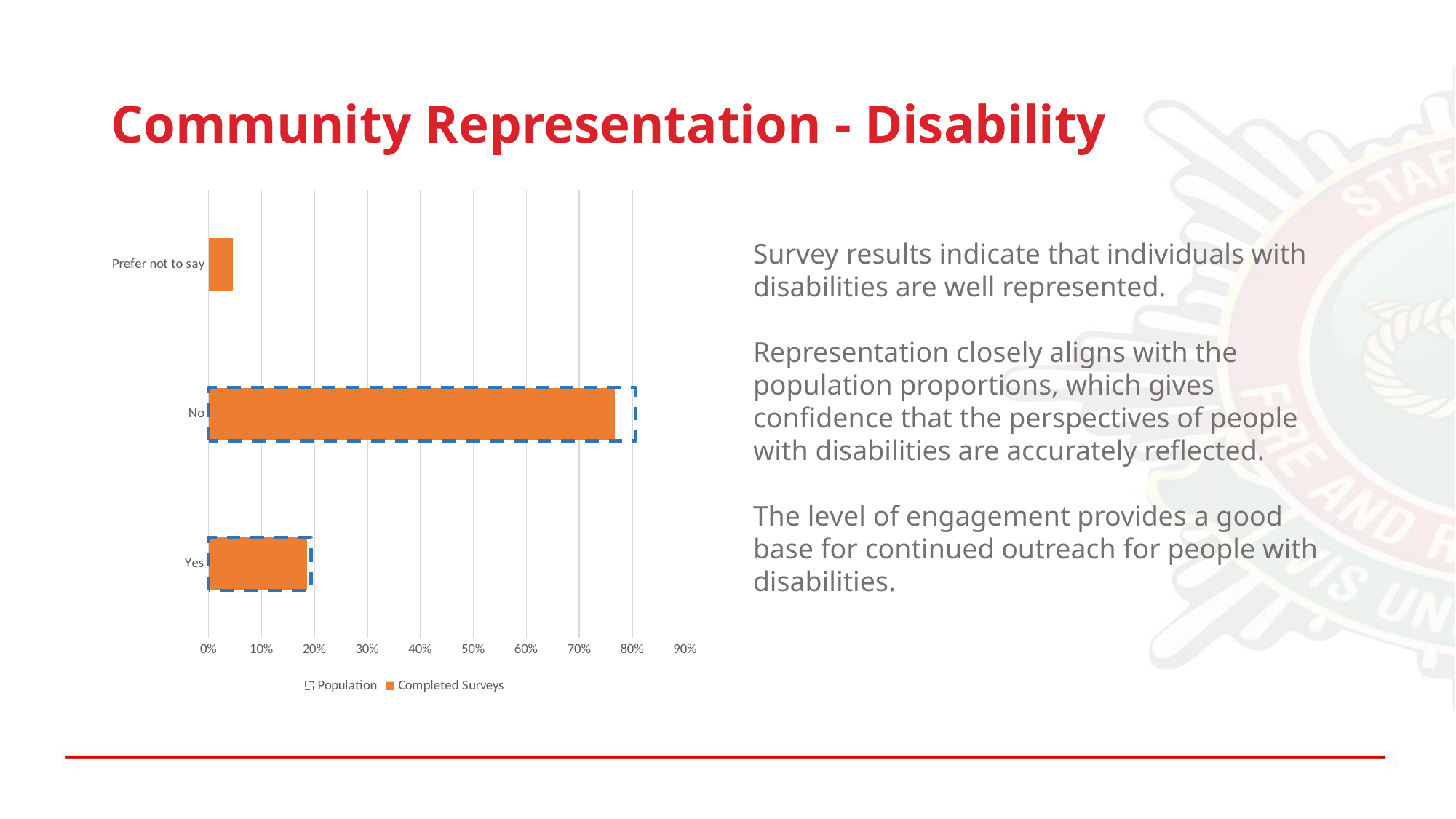
Which series is shown with a dashed outline in the legend? Population Which category has the lowest Completed Surveys value? Prefer not to say What kind of chart is shown on the slide? Bar chart Which category has the highest Completed Surveys value? No Is the Completed Surveys value for No greater or less than 70%? greater How many series does the chart's legend list? 2 What colour are the Completed Surveys bars? Orange How many categories are shown on the chart? 3 Is the Completed Surveys value for Prefer not to say greater or less than 10%? less Is the Completed Surveys value for Yes greater or less than 20%? less Which is larger: the Completed Surveys value for Yes or for Prefer not to say? Yes